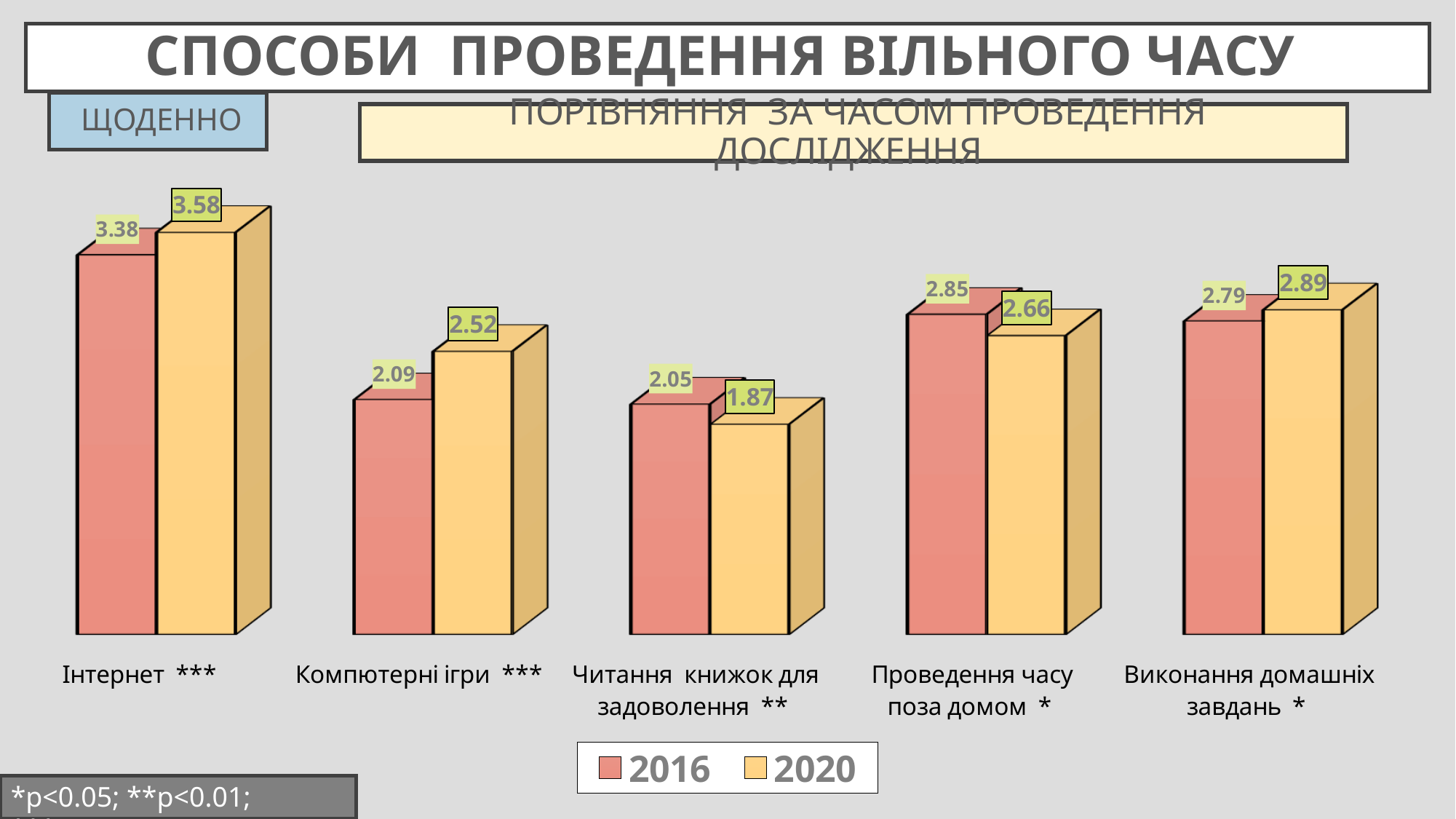
What is the 2020 value for Читання книжок для задоволення? 1.87 How many categories are shown on the chart? 5 What is the difference between the 2020 and 2016 values for Компютерні ігри? 0.43 What kind of chart is shown on the slide? Bar chart For Проведення часу поза домом, which year has the larger value, 2016 or 2020? 2016 Which category has the highest 2020 value? Інтернет Which colour represents the 2020 series in the legend? Yellow/orange How many series does the legend list? 2 What is the 2016 value for Проведення часу поза домом? 2.85 Which category has the lowest 2016 value? Читання книжок для задоволення What is the 2016 value for Інтернет? 3.38 What is the 2020 value for Компютерні ігри? 2.52